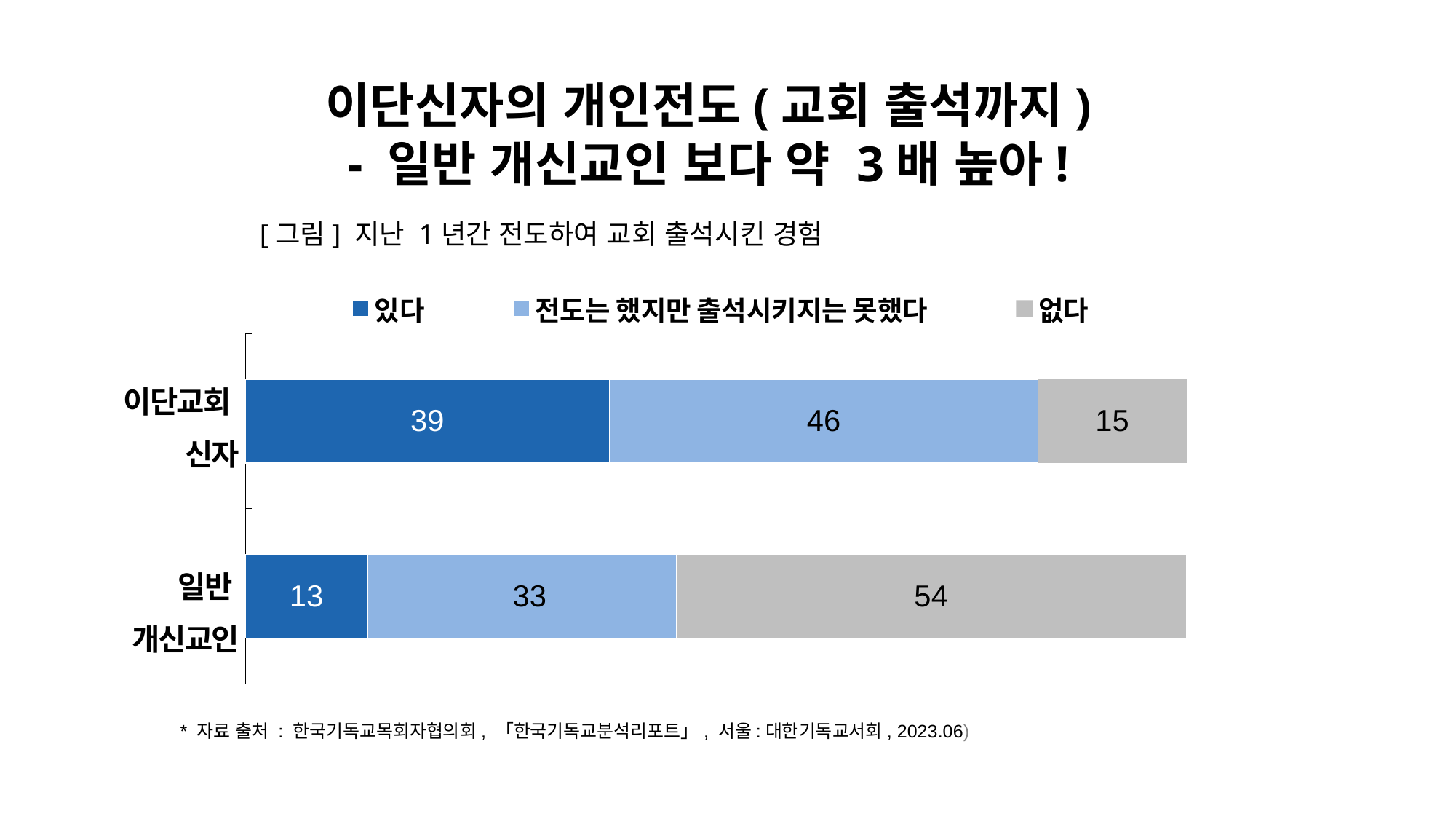
What is the value of '전도는 했지만 출석시키지는 못했다' for '이단교회 신자'? 46 What is the total of the stacked bar for '이단교회 신자'? 100 What is the difference between the '없다' values for '일반 개신교인' and '이단교회 신자'? 39 How many categories are shown on the chart? 2 What is the value of '있다' for '일반 개신교인'? 13 What kind of chart is shown on the slide? Stacked bar chart How many series does the legend list? 3 Which series has the largest value within the '일반 개신교인' bar? 없다 Which category has the higher value for '있다', '이단교회 신자' or '일반 개신교인'? 이단교회 신자 What is the difference between the '있다' values for '이단교회 신자' and '일반 개신교인'? 26 What is the value of '있다' for '이단교회 신자'? 39 What is the value of '없다' for '일반 개신교인'? 54